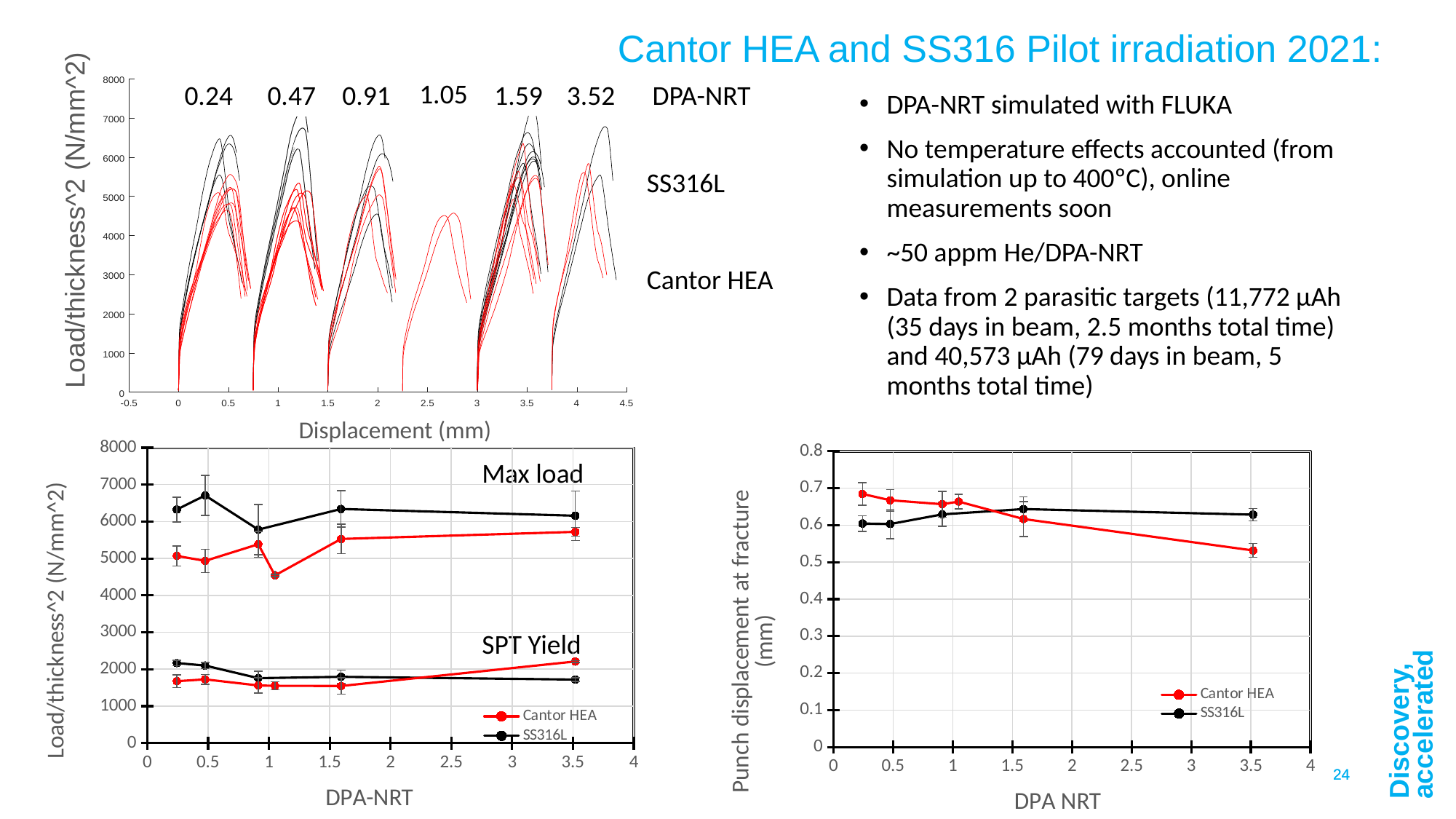
In the bottom-right chart (Punch displacement at fracture), does the Cantor HEA series rise or fall as DPA NRT increases from 0.24 to 3.52? fall In the bottom-left chart (Max load / SPT Yield), is the Max load value for Cantor HEA at DPA-NRT 1.05 greater or less than 5000? less In the bottom-right chart (Punch displacement at fracture), is the value for Cantor HEA at DPA NRT 3.52 greater or less than 0.6? less In the bottom-left chart (Max load / SPT Yield), how many series does the legend list? 2 In the top-left chart (load vs displacement curves), how many DPA-NRT values are labelled above the curve groups? 6 In the bottom-left chart (Max load / SPT Yield), is the SPT Yield value for SS316L at DPA-NRT 0.24 greater or less than 2000? greater In the bottom-left chart (Max load / SPT Yield), which series has the larger Max load at DPA-NRT 0.24, Cantor HEA or SS316L? SS316L In the bottom-right chart (Punch displacement at fracture), what kind of chart is it? line chart In the bottom-left chart (Max load / SPT Yield), does the SPT Yield of Cantor HEA rise or fall between DPA-NRT 1.59 and 3.52? rise In the top-left chart (load vs displacement curves), what is the x-axis title? Displacement (mm)